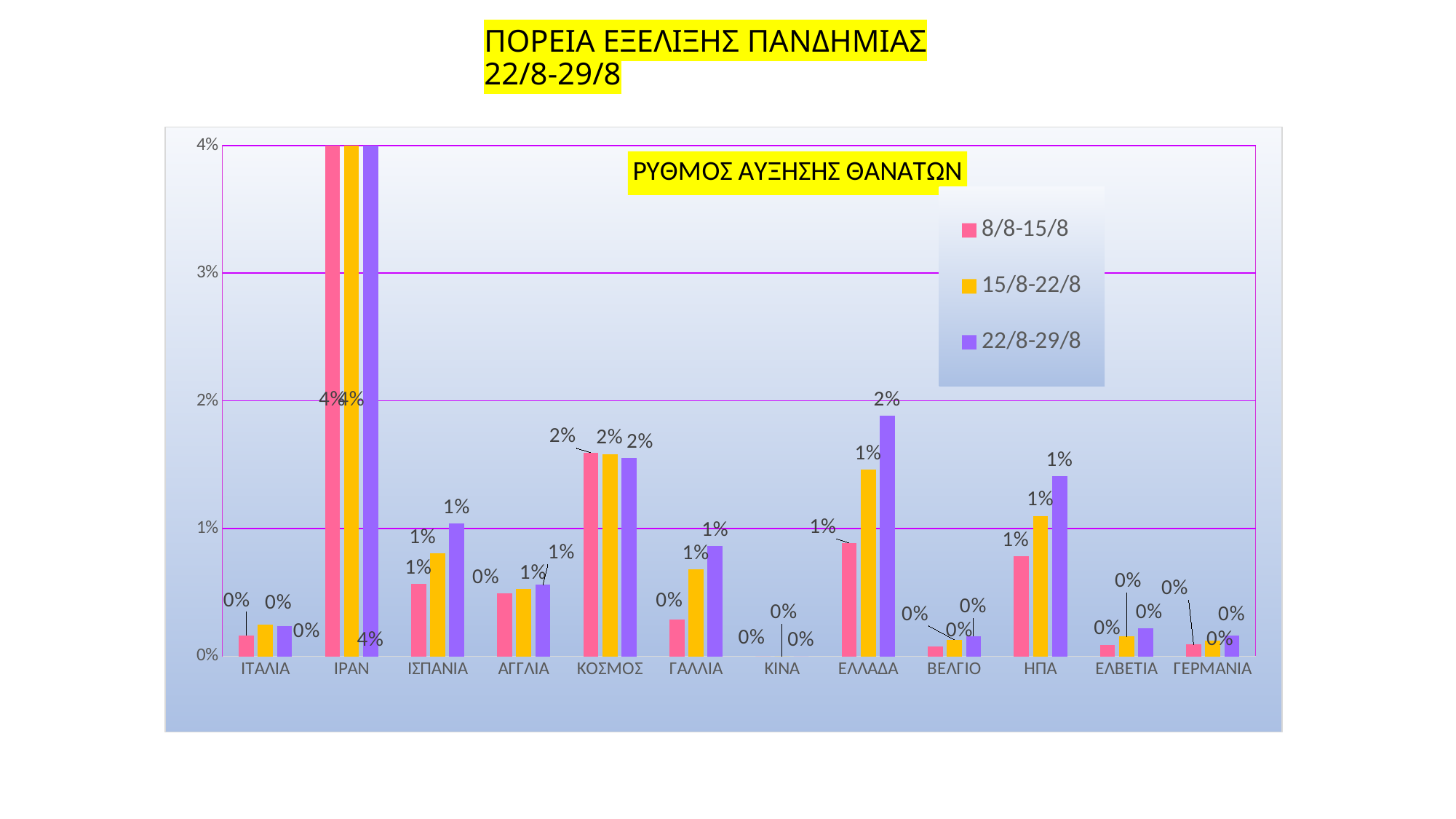
Which category has the lowest values in the chart? ΚΙΝΑ How many series does the legend of the chart list? 3 Do the values for ΕΛΛΑΔΑ rise or fall from the 8/8-15/8 series to the 22/8-29/8 series? rise What kind of chart is shown on the slide? Bar chart How many countries/categories are shown on the x axis of the chart? 12 In the 22/8-29/8 series, which is larger: ΕΛΛΑΔΑ or ΗΠΑ? ΕΛΛΑΔΑ Which category has the highest values in the chart? ΙΡΑΝ What is the value for ΕΛΛΑΔΑ in the 22/8-29/8 series? 2% What is the value for ΙΡΑΝ in the 15/8-22/8 series? 4% What is the value for ΚΟΣΜΟΣ in the 8/8-15/8 series? 2% What is the title shown inside the chart area? ΡΥΘΜΟΣ ΑΥΞΗΣΗΣ ΘΑΝΑΤΩΝ Is the value for ΚΟΣΜΟΣ in the 22/8-29/8 series greater or less than 1%? greater